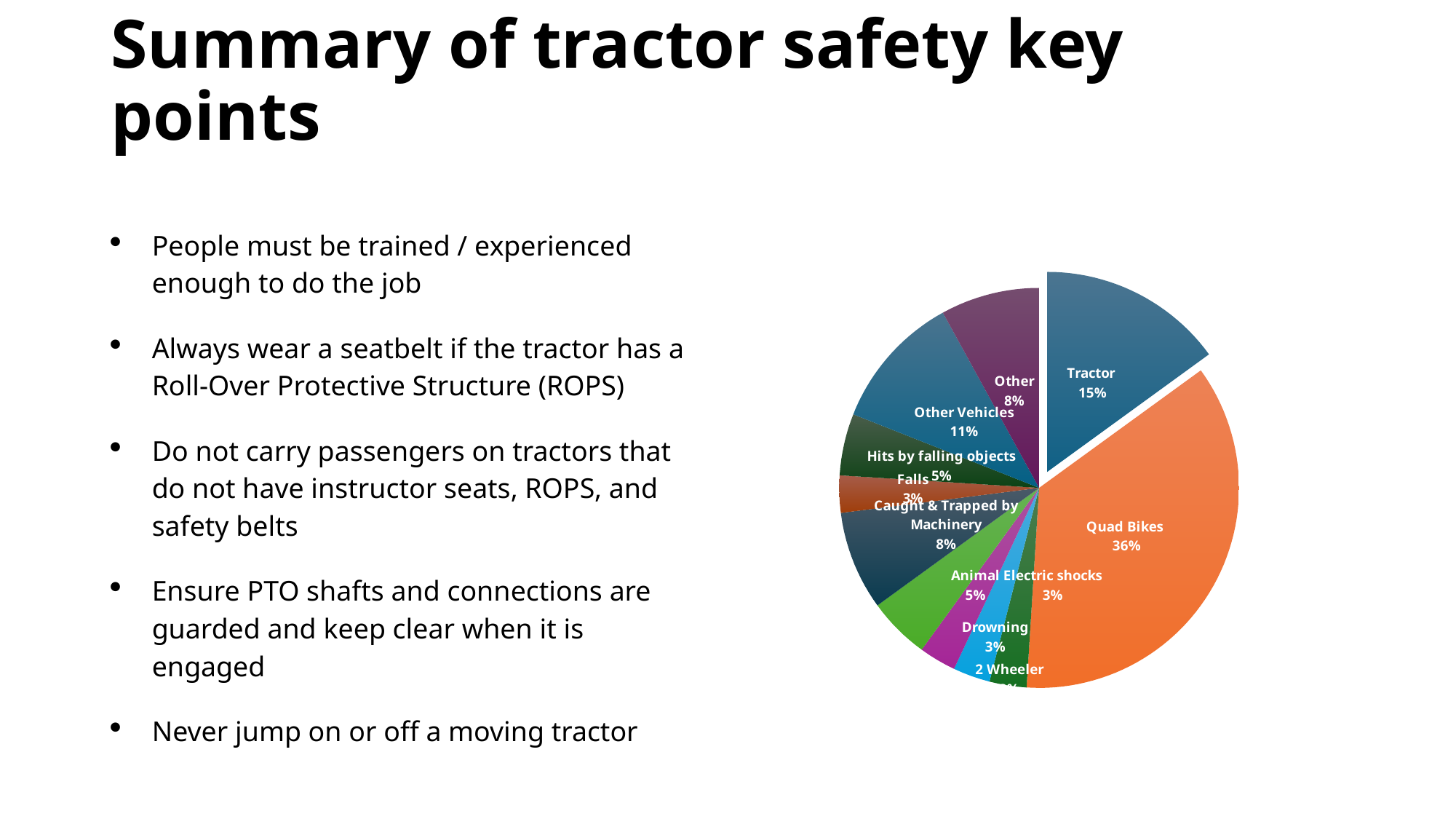
What is the value shown for Caught & Trapped by Machinery? 8% What share of the pie does Quad Bikes account for? 36% What colour is the Quad Bikes slice in the pie chart? Orange Which slice is pulled out (exploded) from the rest of the pie chart? Tractor What is the value shown for Other Vehicles in the pie chart? 11% What is the value shown for Hits by falling objects? 5% What type of chart is shown on the slide? Pie chart Which category has the largest slice of the pie chart? Quad Bikes What is the difference in percentage points between Quad Bikes and Tractor? 21 Which is larger, the share for Other Vehicles or the share for Animal? Other Vehicles What is the value shown for Tractor in the pie chart? 15% What is the value shown for Drowning in the pie chart? 3%